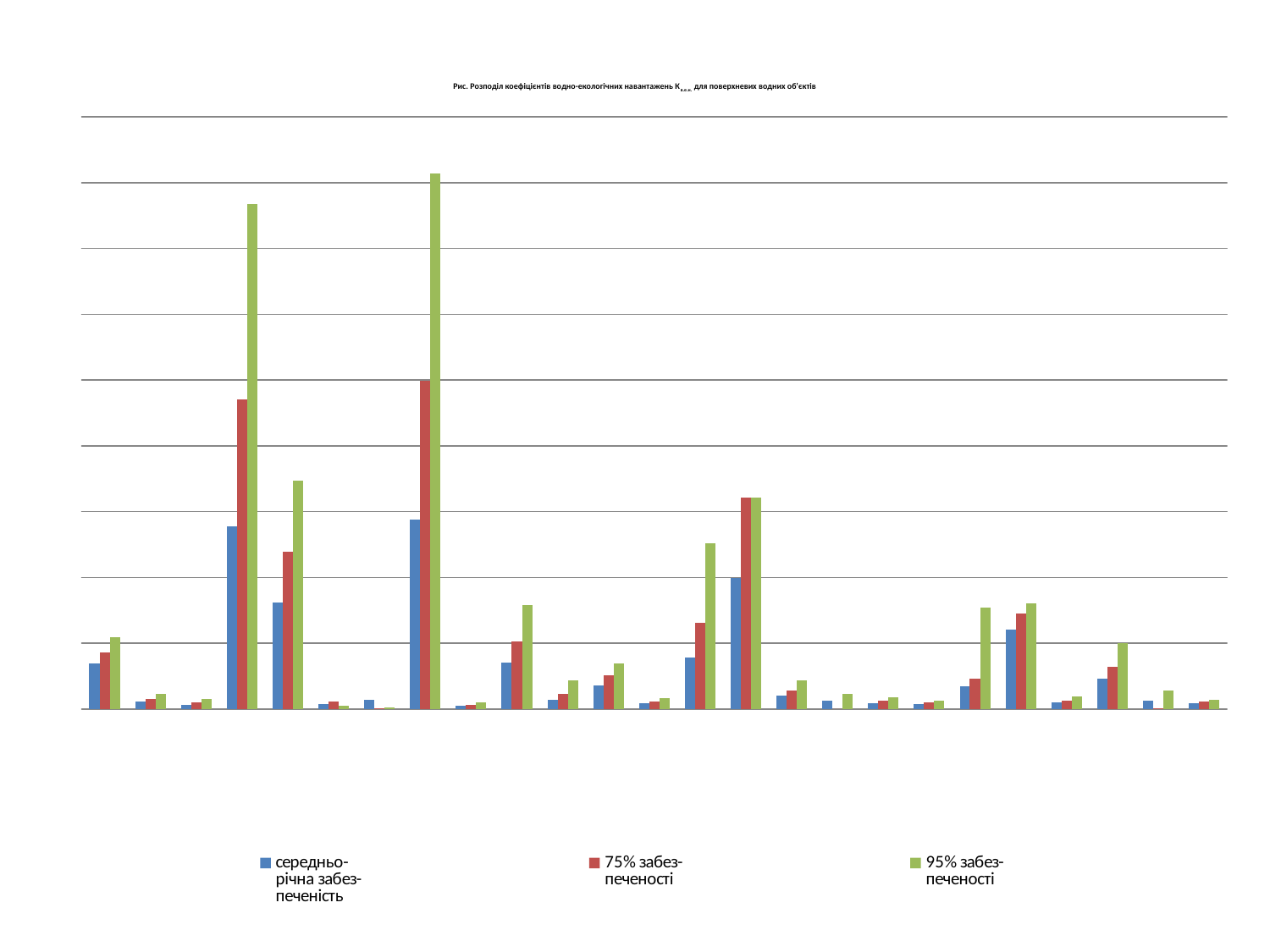
Which series has the shortest bar in the group containing the tallest bar on the chart? середньо-річна забез-печеність How many groups of bars (categories) are plotted along the x axis? 25 Which series contains the tallest bar on the chart? 95% забез-печеності Which series does the legend list first? середньо-річна забез-печеність What kind of chart is shown on the slide? bar chart What colour are the bars for the series '95% забез-печеності'? green How many series does the legend list? 3 In the group containing the tallest bar on the chart, which is larger: the '75% забез-печеності' bar or the '95% забез-печеності' bar? 95% забез-печеності